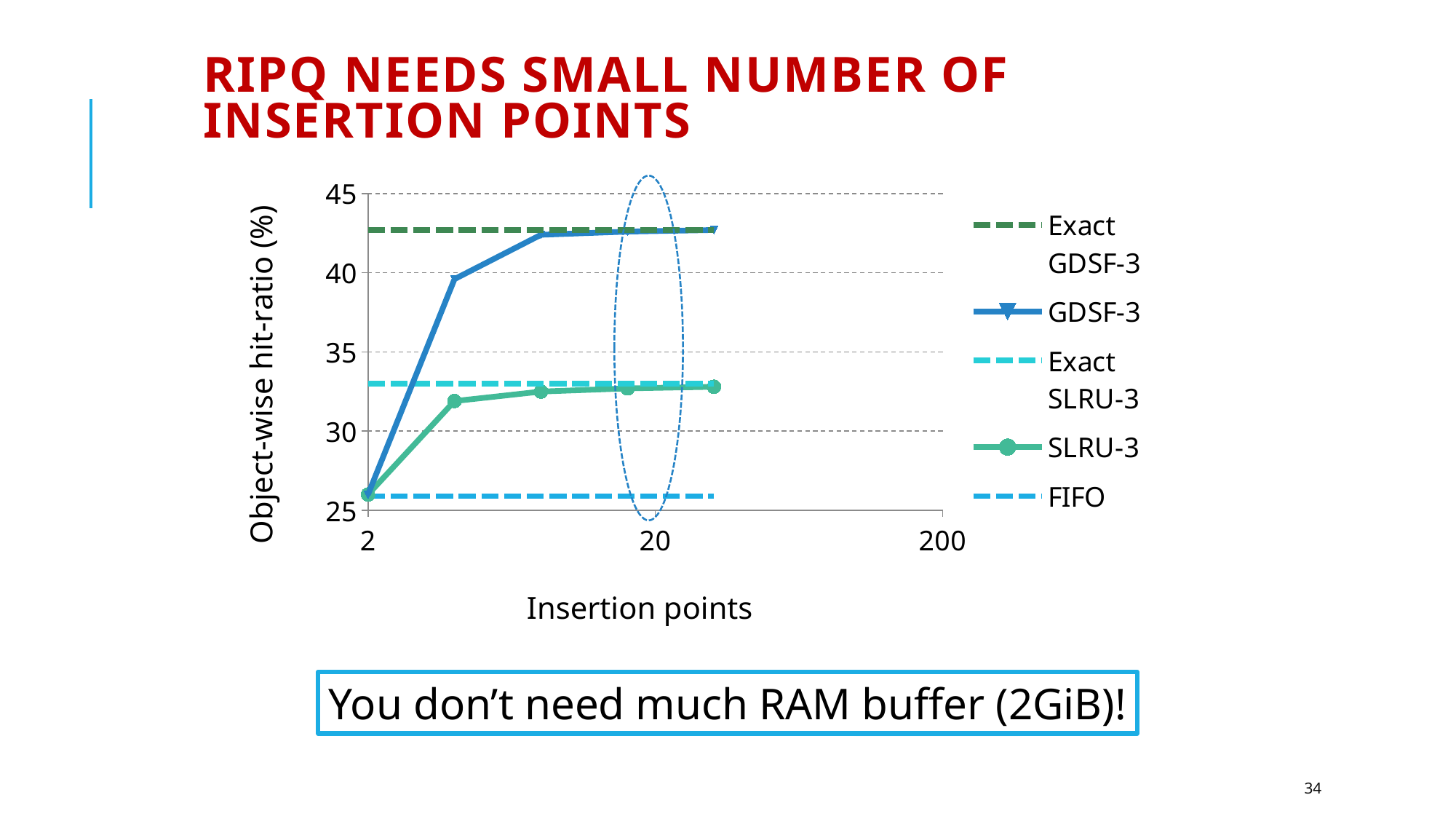
Is the FIFO value greater or less than 30? less Does the GDSF-3 hit-ratio rise or fall as the number of insertion points increases? rise Is the SLRU-3 value at 20 insertion points greater or less than 35? less Which series has the lowest hit-ratio on the chart? FIFO What is the label of the y axis? Object-wise hit-ratio (%) At 20 insertion points, which has the higher hit-ratio, GDSF-3 or SLRU-3? GDSF-3 How many series does the legend list? 5 Is the GDSF-3 value at 2 insertion points greater or less than 30? less Which is higher, the Exact GDSF-3 line or the Exact SLRU-3 line? Exact GDSF-3 What kind of chart is shown on the slide? line chart What is the label of the x axis? Insertion points